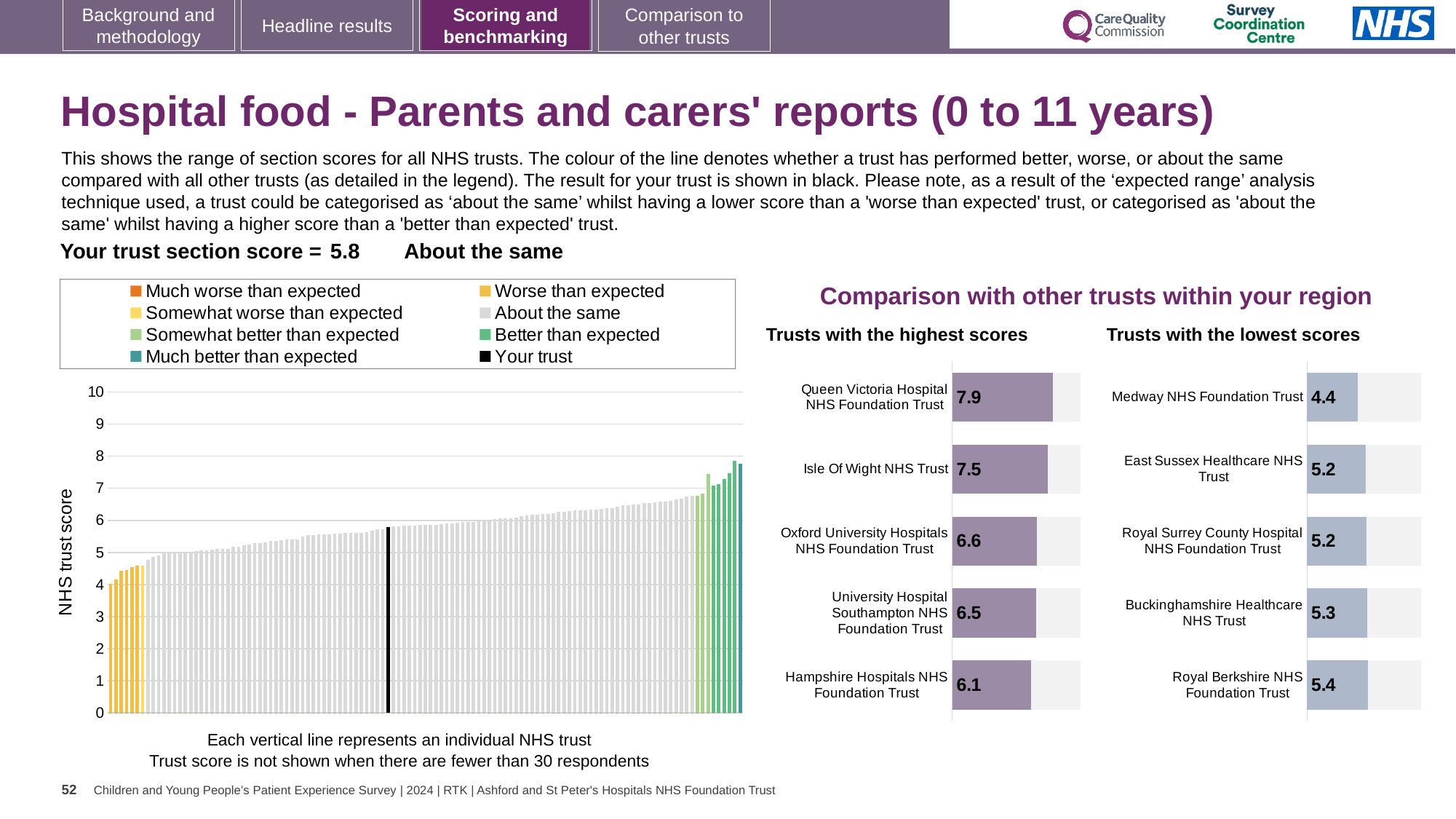
In the 'Trusts with the highest scores' chart, which trust has the highest score? Queen Victoria Hospital NHS Foundation Trust In the 'Trusts with the highest scores' chart, what is the difference between the scores of Queen Victoria Hospital NHS Foundation Trust and Hampshire Hospitals NHS Foundation Trust? 1.8 In the 'Trusts with the lowest scores' chart, which has the higher score: Buckinghamshire Healthcare NHS Trust or Royal Berkshire NHS Foundation Trust? Royal Berkshire NHS Foundation Trust In the 'Trusts with the highest scores' chart, what is the score for Queen Victoria Hospital NHS Foundation Trust? 7.9 In the 'Trusts with the highest scores' chart, what is the score for Hampshire Hospitals NHS Foundation Trust? 6.1 In the 'Trusts with the lowest scores' chart, which trust has the lowest score? Medway NHS Foundation Trust In the large chart on the left showing all NHS trusts, what is the label on the vertical axis? NHS trust score In the 'Trusts with the lowest scores' chart, what is the difference between the scores of Royal Berkshire NHS Foundation Trust and Medway NHS Foundation Trust? 1.0 In the 'Trusts with the highest scores' chart, how many trusts are shown? 5 In the large chart on the left showing all NHS trusts, what kind of chart is it? Bar chart In the large chart on the left showing all NHS trusts, is the value for the black bar (your trust) greater or less than 6? less In the 'Trusts with the lowest scores' chart, what is the score for Medway NHS Foundation Trust? 4.4